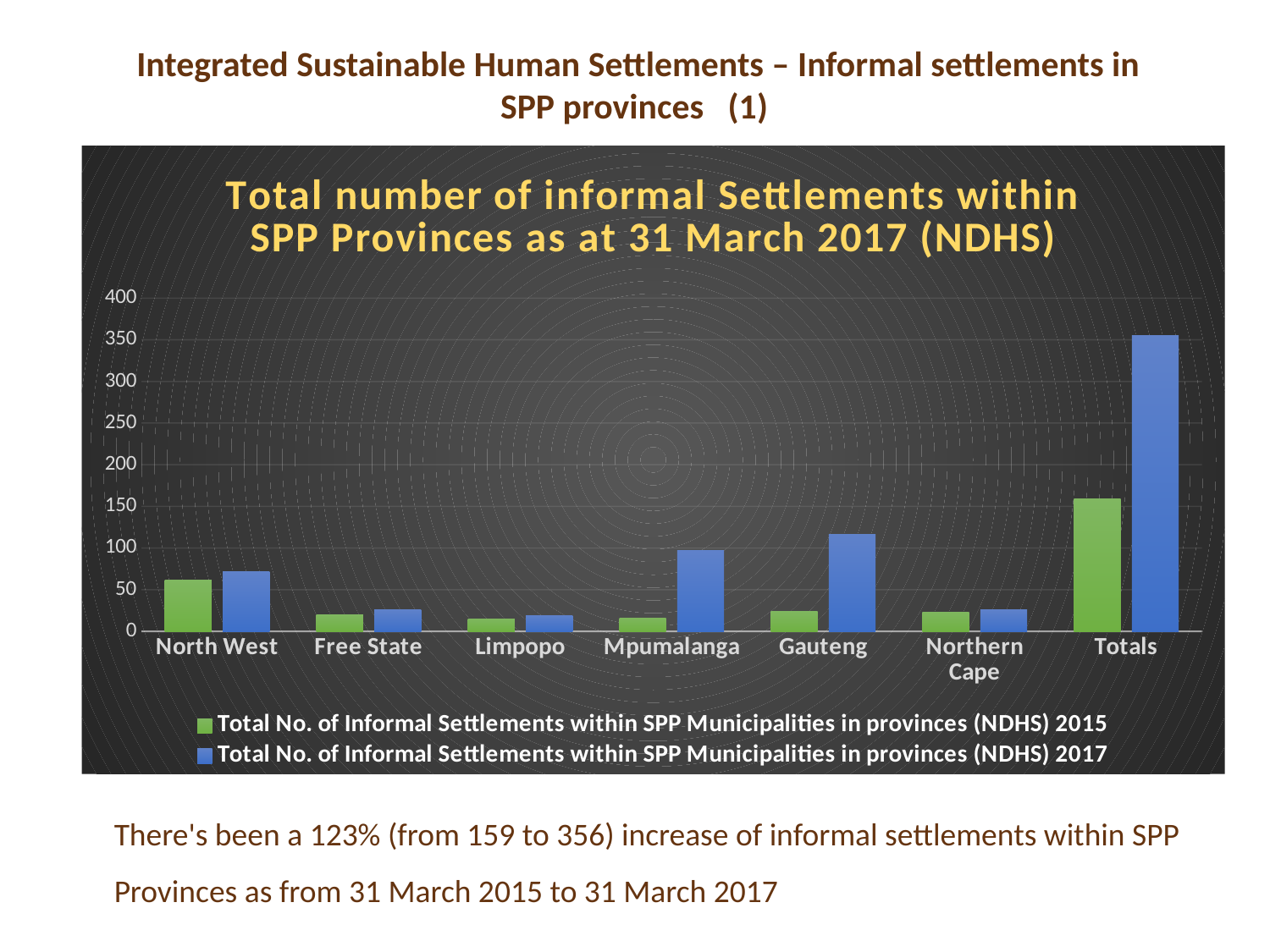
For Mpumalanga, which is larger: the 2015 value or the 2017 value? 2017 What is the Totals value for 2017 according to the slide? 356 What is the Totals value for 2015 according to the slide? 159 What kind of chart is shown on the slide? Bar chart Is the 2017 value for North West greater or less than 50? greater How many series does the legend list? 2 Is the 2017 value for Gauteng greater or less than 100? greater Which province has the highest number of informal settlements in 2017 (excluding Totals)? Gauteng Which colour represents the 2017 series in the chart? Blue How many categories are shown along the x axis of the chart? 7 Is the 2015 value for Free State greater or less than 50? less Which province has the highest number of informal settlements in 2015 (excluding Totals)? North West